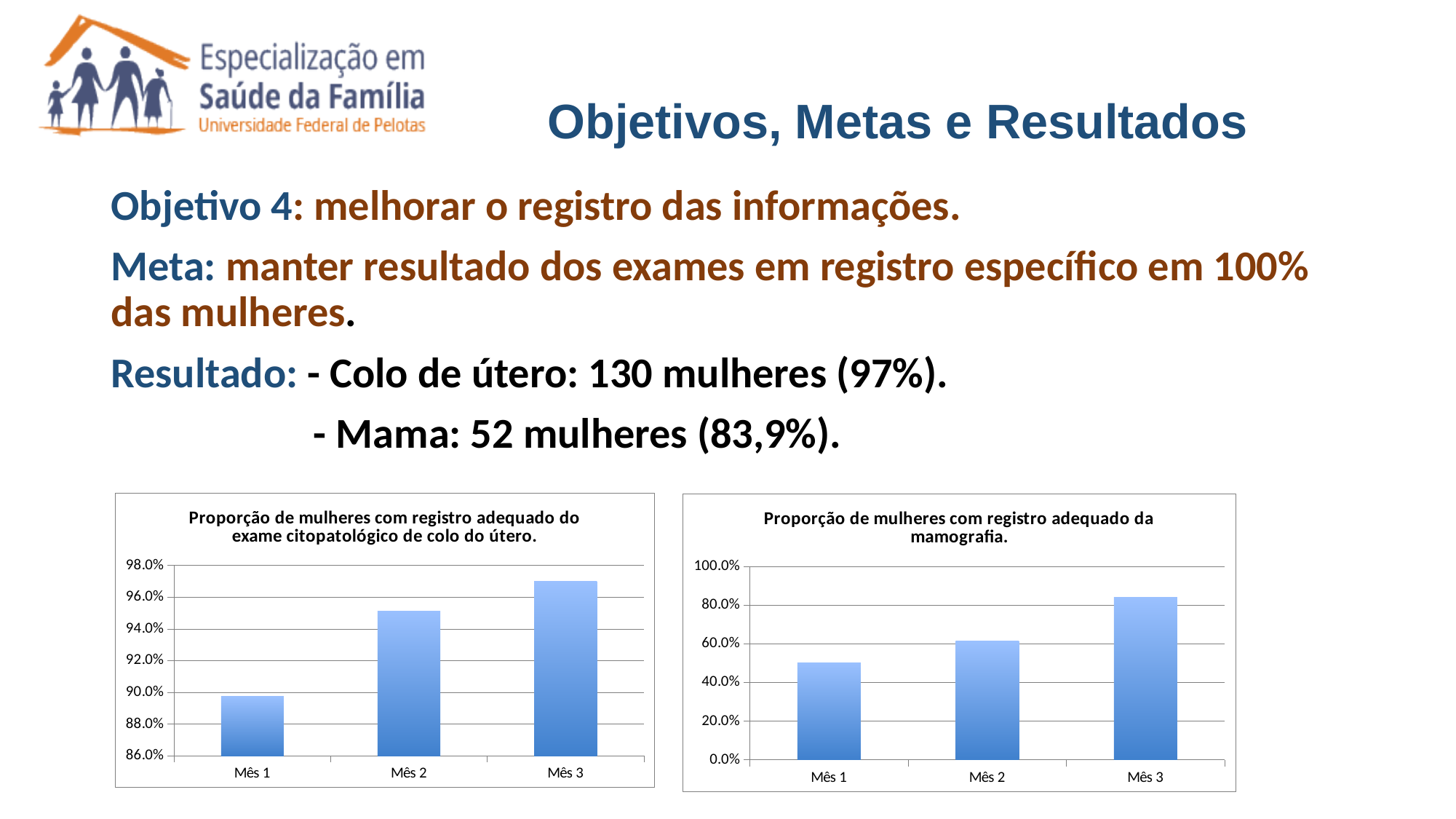
In the left chart (registro adequado do exame citopatológico de colo do útero), is the value for Mês 3 greater or less than 96.0%? greater How many months are shown on the x axis of the right chart, 'Proporção de mulheres com registro adequado da mamografia'? 3 In the right chart (registro adequado da mamografia), is the value for Mês 1 greater or less than 60.0%? less In the left chart (registro adequado do exame citopatológico de colo do útero), do the values rise or fall from Mês 1 to Mês 3? rise In the right chart (registro adequado da mamografia), which month has the highest value? Mês 3 In the right chart (registro adequado da mamografia), which is larger, the value for Mês 2 or the value for Mês 3? Mês 3 What kind of chart is the left chart, 'Proporção de mulheres com registro adequado do exame citopatológico de colo do útero'? bar chart In the right chart (registro adequado da mamografia), is the value for Mês 3 greater or less than 80.0%? greater In the left chart (registro adequado do exame citopatológico de colo do útero), which month has the lowest value? Mês 1 In the left chart (registro adequado do exame citopatológico de colo do útero), which month has the highest value? Mês 3 What is the title of the right chart on the slide? Proporção de mulheres com registro adequado da mamografia.